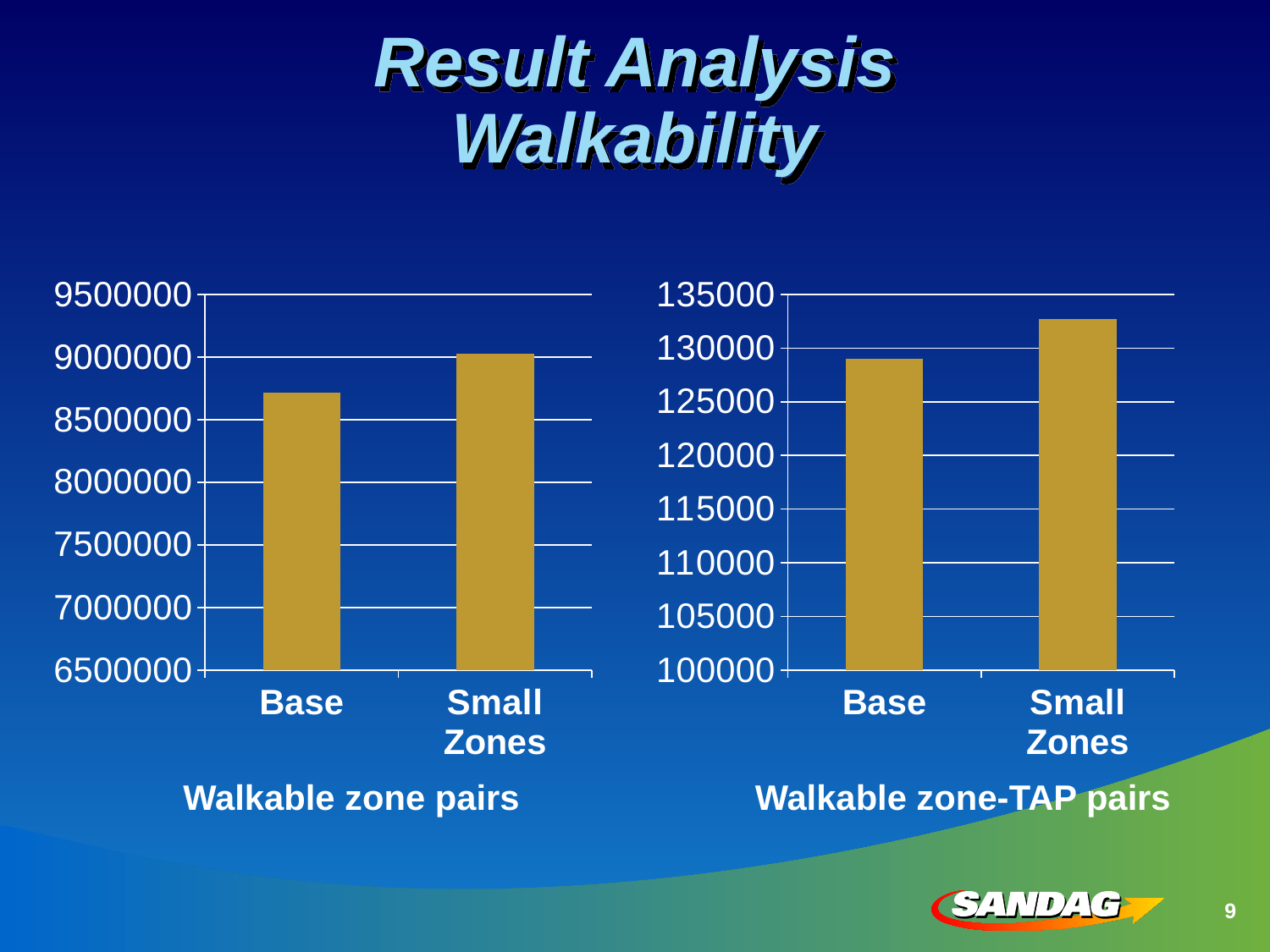
In the Walkable zone-TAP pairs chart, which category has the higher value? Small Zones In the Walkable zone pairs chart, is the value for Base greater or less than 8500000? greater In the Walkable zone pairs chart, which category has the higher value? Small Zones In the Walkable zone-TAP pairs chart, which category has the lower value? Base How many categories are shown in the Walkable zone pairs chart? 2 In the Walkable zone pairs chart, which category has the lower value? Base In the Walkable zone-TAP pairs chart, is the value for Base greater or less than 130000? less In the Walkable zone pairs chart, do the values rise or fall from Base to Small Zones? rise In the Walkable zone pairs chart, is the value for Base greater or less than 9000000? less What kind of chart is the Walkable zone-TAP pairs chart? bar chart In the Walkable zone-TAP pairs chart, is the value for Base larger or smaller than the value for Small Zones? smaller